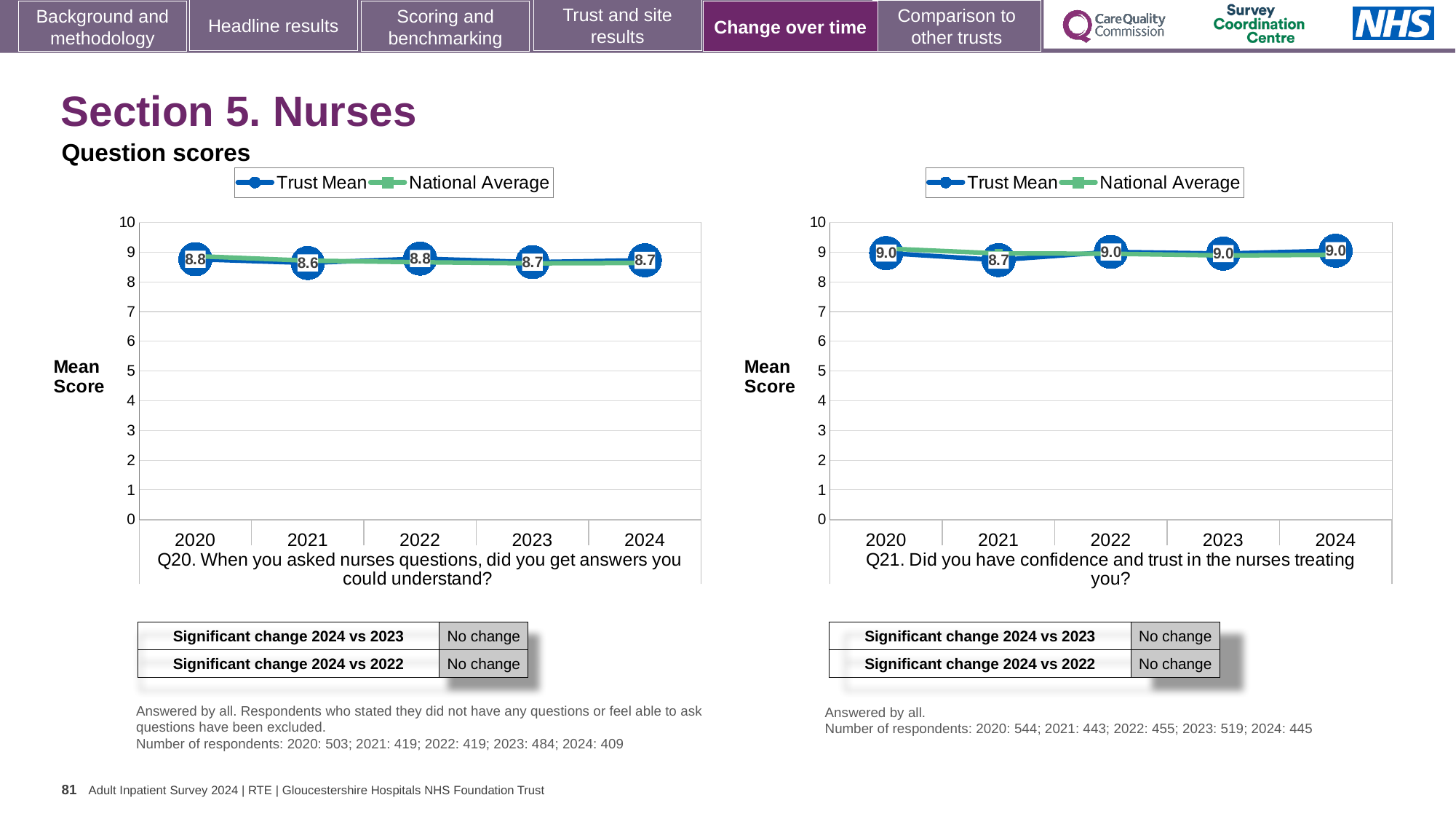
On the Q21 chart, is the National Average value for 2024 greater or less than 8? greater On the Q21 chart, what is the Trust Mean value for 2021? 8.7 On the Q20 chart, which year has the lowest Trust Mean value? 2021 On the Q21 chart, what is the difference between the Trust Mean values for 2020 and 2021? 0.3 What type of chart is the Q20 chart? Line chart On the Q20 chart, what is the Trust Mean value for 2020? 8.8 On the Q21 chart, which year has the lowest Trust Mean value? 2021 On the Q20 chart, what is the difference between the Trust Mean values for 2022 and 2021? 0.2 On the Q20 chart, what is the Trust Mean value for 2021? 8.6 How many years are plotted on the Q20 chart? 5 On the Q21 chart, what is the Trust Mean value for 2024? 9.0 How many series does the legend of the Q21 chart list? 2